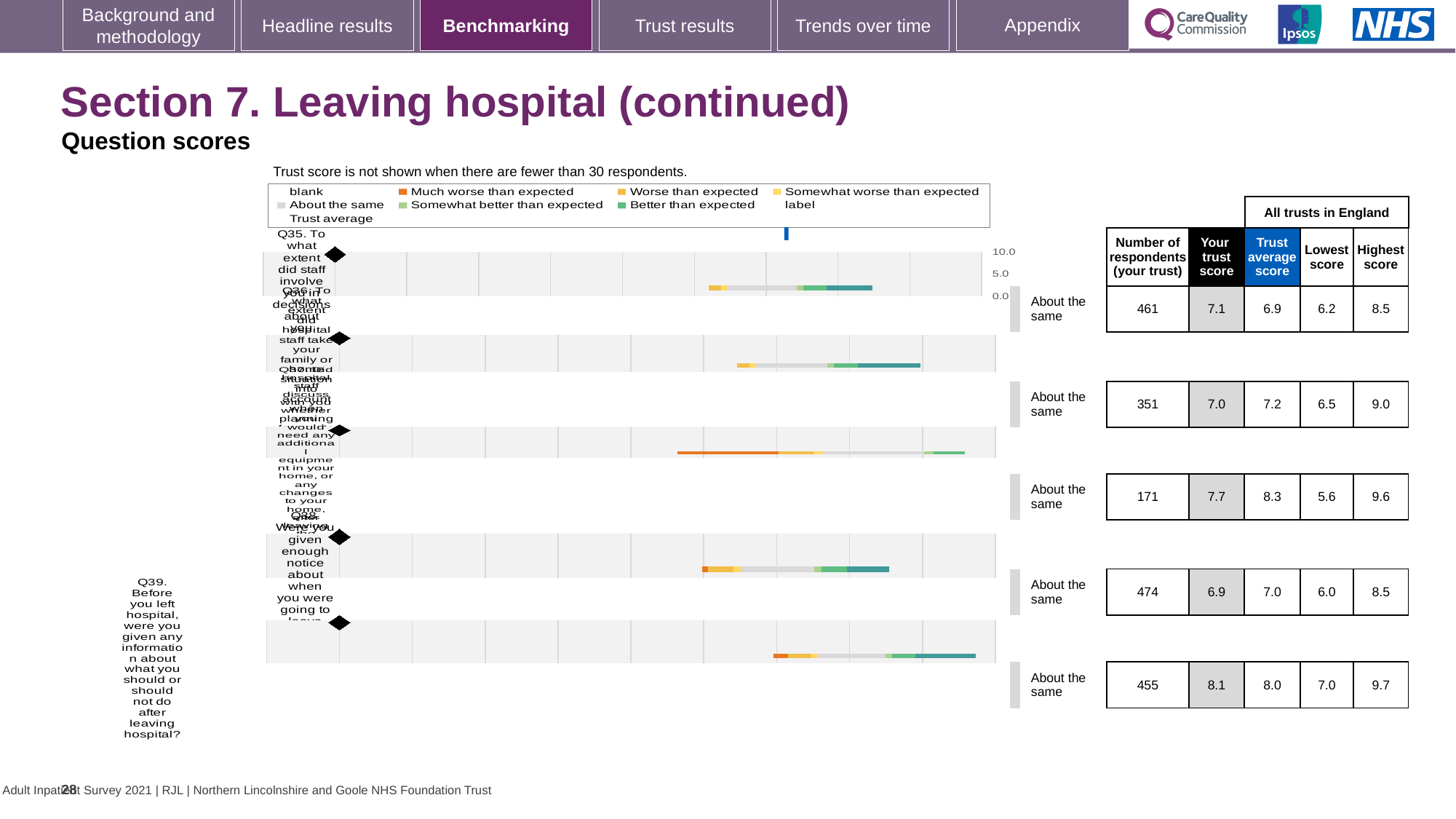
In the table, what is the trust average score for the third row (Q37)? 8.3 What does the legend entry with the orange colour represent? Much worse than expected For the fourth row (Q38), which is larger: the trust score or the trust average score? Trust average score (7.0) How many questions (rows) are plotted in the benchmarking chart? 5 In the table, what is the highest score for the last row (Q39)? 9.7 What is the difference between the highest score and the lowest score for the third row (Q37)? 4.0 Which row in the table has the lowest number of respondents? Q37 (171) In the table, what is the trust score for the last row (Q39)? 8.1 What benchmark category is shown for every question on this slide? About the same What kind of chart is used to show the question scores on this slide? bar chart In the table, what is the number of respondents for the first row (Q35)? 461 Which row in the table has the highest trust score? Q39 (8.1)